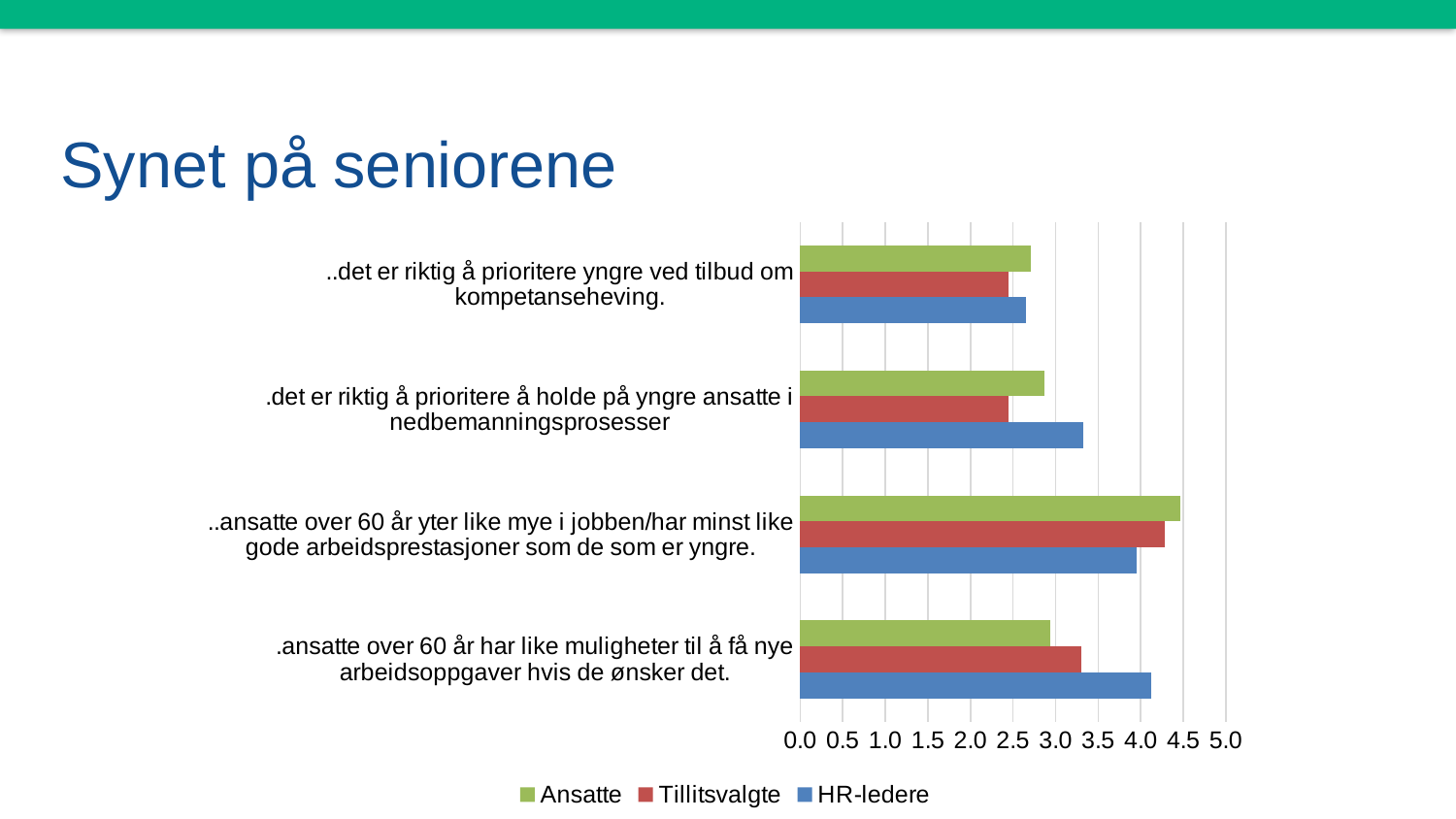
For "..ansatte over 60 år yter like mye i jobben/har minst like gode arbeidsprestasjoner som de som er yngre.", which is larger: the Ansatte value or the HR-ledere value? Ansatte What is the title of the slide? Synet på seniorene What kind of chart is shown on the slide? Bar chart Is the Ansatte value for "..ansatte over 60 år yter like mye i jobben/har minst like gode arbeidsprestasjoner som de som er yngre." greater or less than 4.0? greater Is the Tillitsvalgte value for "..det er riktig å prioritere yngre ved tilbud om kompetanseheving." greater or less than 3.0? less Which series has the lowest value for "..det er riktig å prioritere å holde på yngre ansatte i nedbemanningsprosesser"? Tillitsvalgte What colour represents the HR-ledere series in the chart? Blue How many categories (statements) are plotted on the chart? 4 For which statement is the Ansatte value highest? ..ansatte over 60 år yter like mye i jobben/har minst like gode arbeidsprestasjoner som de som er yngre. How many series does the legend list? 3 Is the HR-ledere value for "..ansatte over 60 år har like muligheter til å få nye arbeidsoppgaver hvis de ønsker det." greater or less than 3.5? greater For "..det er riktig å prioritere å holde på yngre ansatte i nedbemanningsprosesser", which is larger: the HR-ledere value or the Ansatte value? HR-ledere